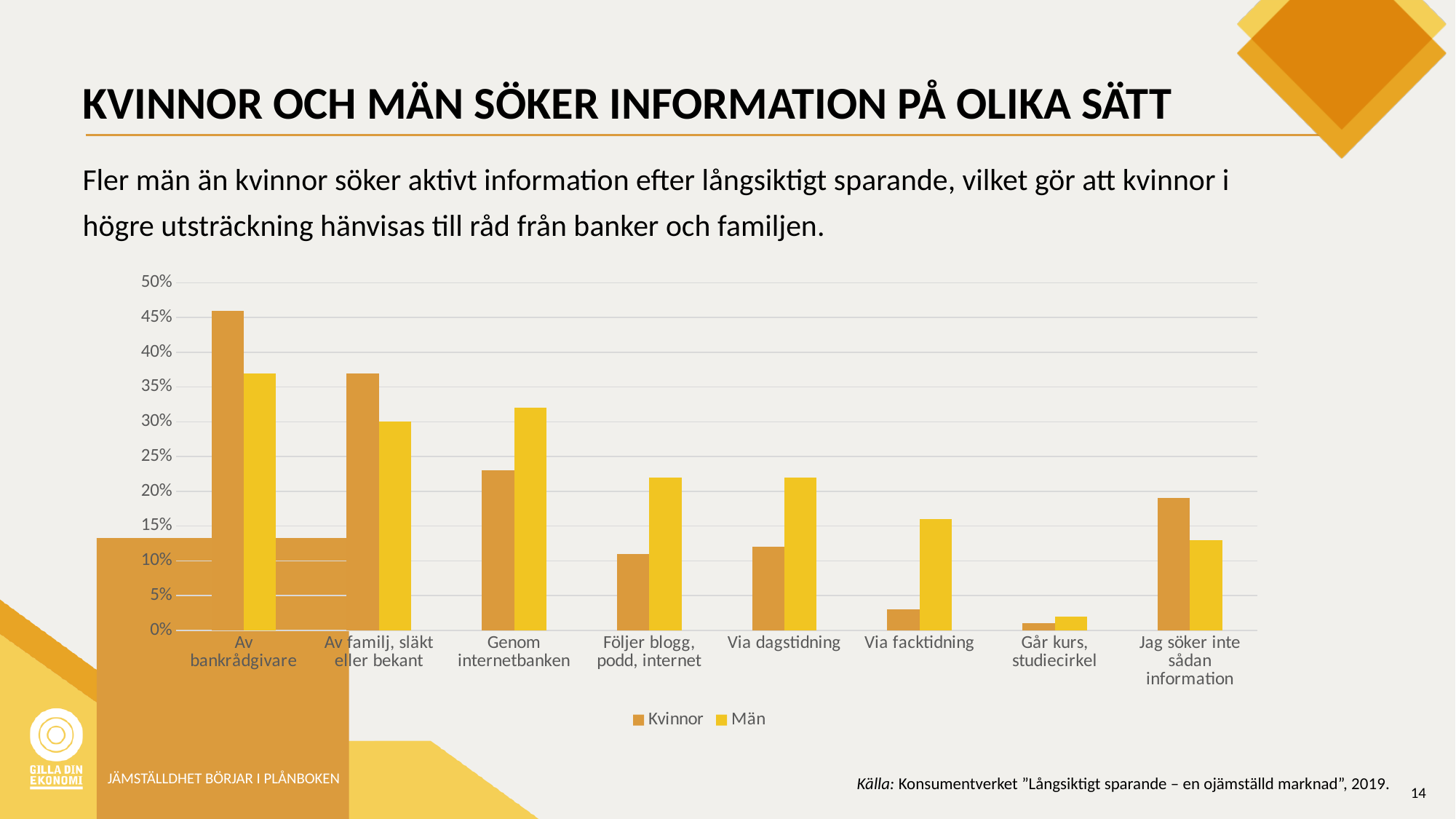
For Genom internetbanken, which series has the larger value, Kvinnor or Män? Män Which series are listed in the chart's legend? Kvinnor and Män For which category is the Kvinnor value lowest? Går kurs, studiecirkel What kind of chart is shown on the slide? bar chart For which category is the Män value lowest? Går kurs, studiecirkel For which category is the Män value highest? Av bankrådgivare For which category is the Kvinnor value highest? Av bankrådgivare For Jag söker inte sådan information, which series has the larger value, Kvinnor or Män? Kvinnor How many series does the chart's legend list? 2 Is the Kvinnor value for Av bankrådgivare greater or less than 40%? greater How many categories are shown on the x axis of the chart? 8 Is the Män value for Via facktidning greater or less than 10%? greater